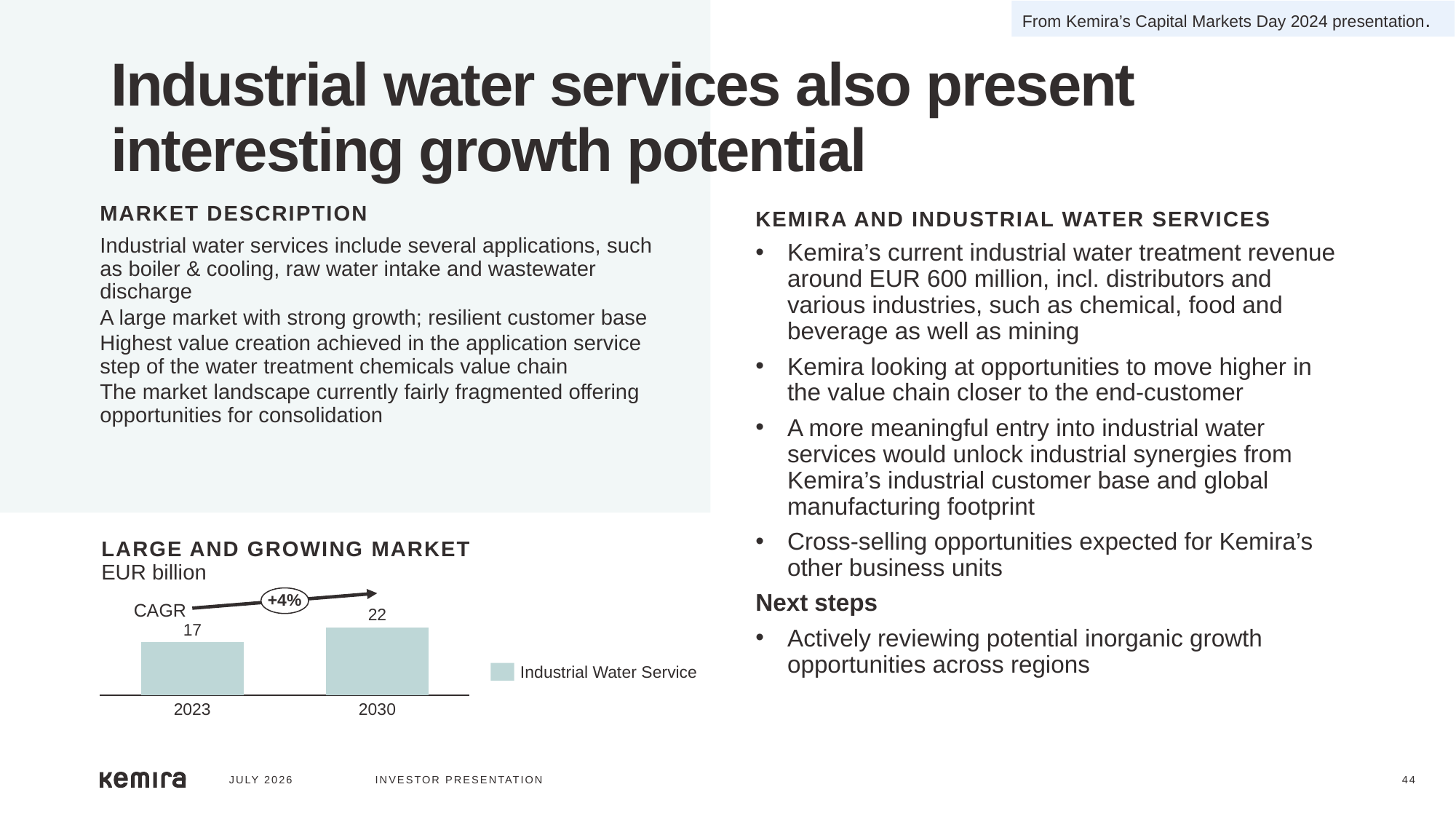
What is the difference between the 2030 and 2023 values in the Large and Growing Market chart? 5 What unit is stated for the Large and Growing Market chart? EUR billion Which year has the lower value in the Large and Growing Market chart? 2023 Is the value for 2030 larger or smaller than the value for 2023 in the Large and Growing Market chart? larger Do the values rise or fall from 2023 to 2030 in the Large and Growing Market chart? rise What CAGR is shown on the Large and Growing Market chart? +4% How many series does the legend of the Large and Growing Market chart list? 1 Which year has the higher value in the Large and Growing Market chart? 2030 What kind of chart is the Large and Growing Market chart? bar chart How many bars are shown in the Large and Growing Market chart? 2 What is the value for 2023 in the Large and Growing Market chart? 17 What is the value for 2030 in the Large and Growing Market chart? 22